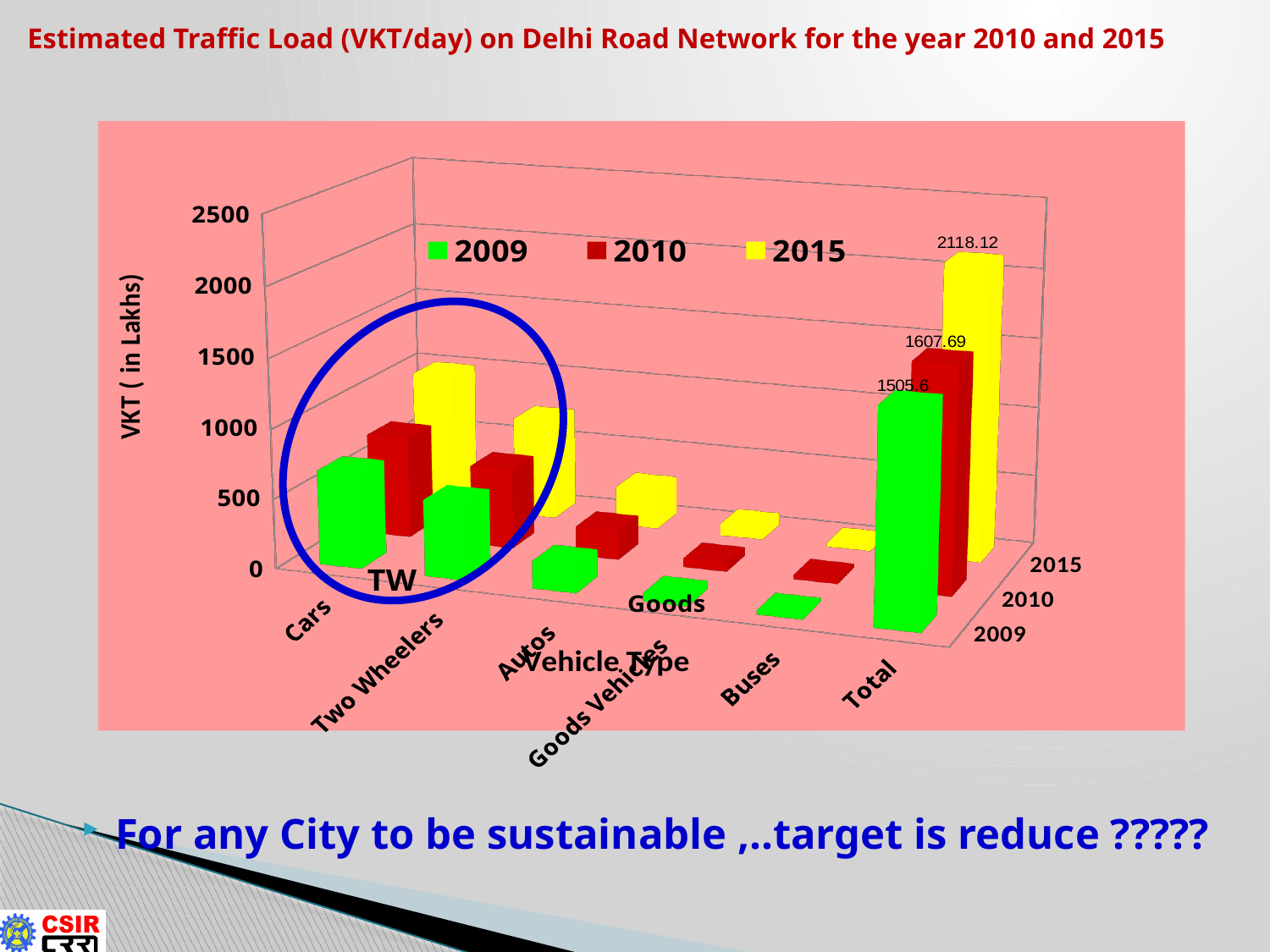
What is the title of the vertical axis? VKT ( in Lakhs) Which is larger for Total: the 2010 value or the 2015 value? 2015 Do the Total values rise or fall from 2009 to 2015? Rise What is the difference between the Total values for 2010 and 2009? 102.09 What is the difference between the Total values for 2015 and 2010? 510.43 How many vehicle type categories are shown on the x axis? 6 Which vehicle type category has the lowest values across the series? Buses What kind of chart is shown on the slide? Bar chart What is the value for Total in the 2010 series? 1607.69 What is the value for Total in the 2009 series? 1505.6 How many series does the legend list? 3 What is the value for Total in the 2015 series? 2118.12